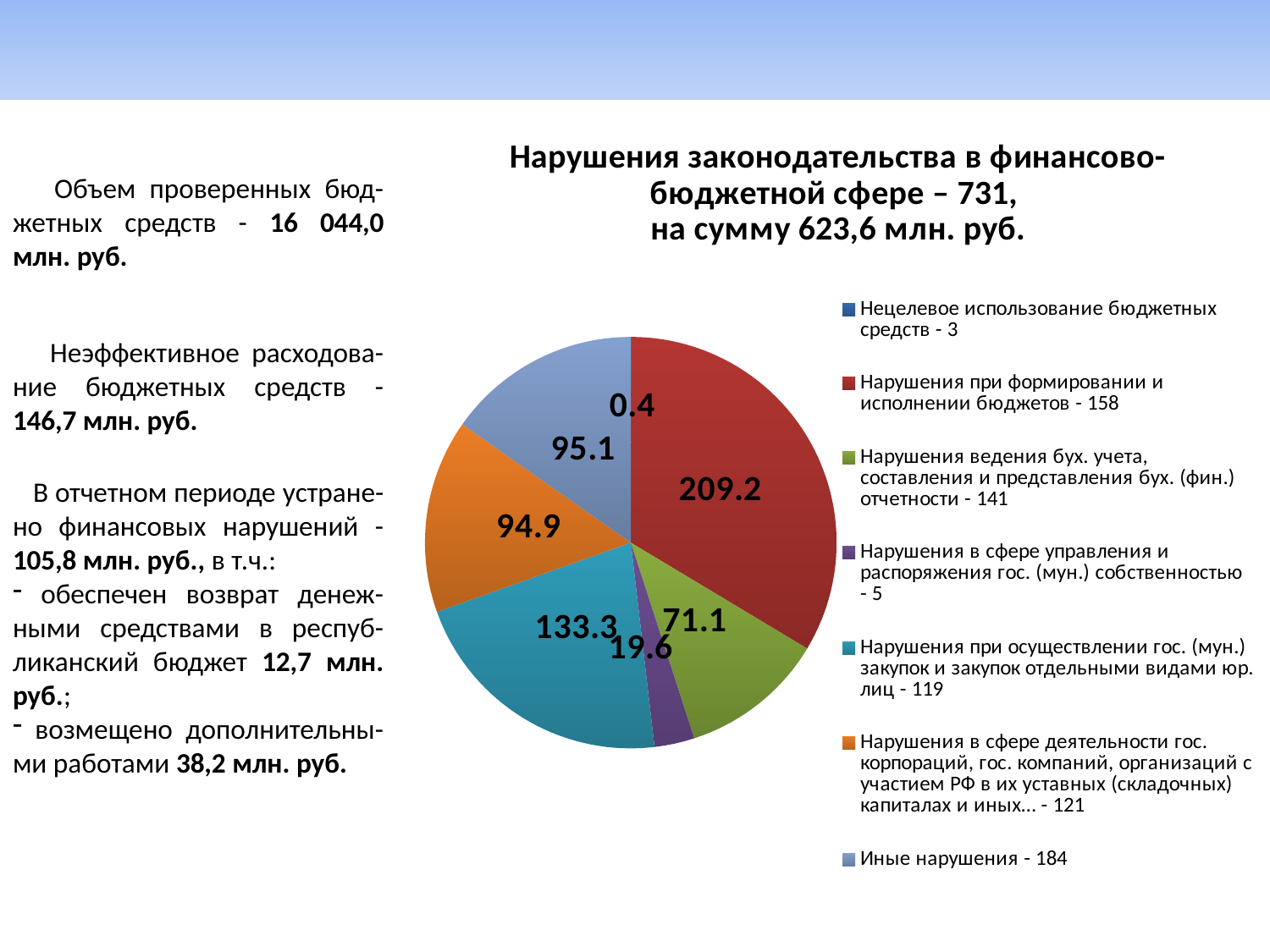
What is the value for 'Нецелевое использование бюджетных средств'? 0.4 What is the value for 'Нарушения при осуществлении гос. (мун.) закупок и закупок отдельными видами юр. лиц'? 133.3 What is the difference between the values for 'Нарушения при формировании и исполнении бюджетов' and 'Нарушения при осуществлении гос. (мун.) закупок'? 75.9 What type of chart is shown on the slide? pie chart What is the value for 'Нарушения при формировании и исполнении бюджетов'? 209.2 Which category has the largest slice of the pie? Нарушения при формировании и исполнении бюджетов What is the value for 'Нарушения в сфере управления и распоряжения гос. (мун.) собственностью'? 19.6 How many slices does the pie chart have? 7 Which category has the smallest slice of the pie? Нецелевое использование бюджетных средств How many entries does the legend list? 7 According to the chart title, what is the total number of violations in the financial and budgetary sphere? 731 Which is larger: the value for 'Нарушения при осуществлении гос. (мун.) закупок' or for 'Нарушения ведения бух. учета'? Нарушения при осуществлении гос. (мун.) закупок